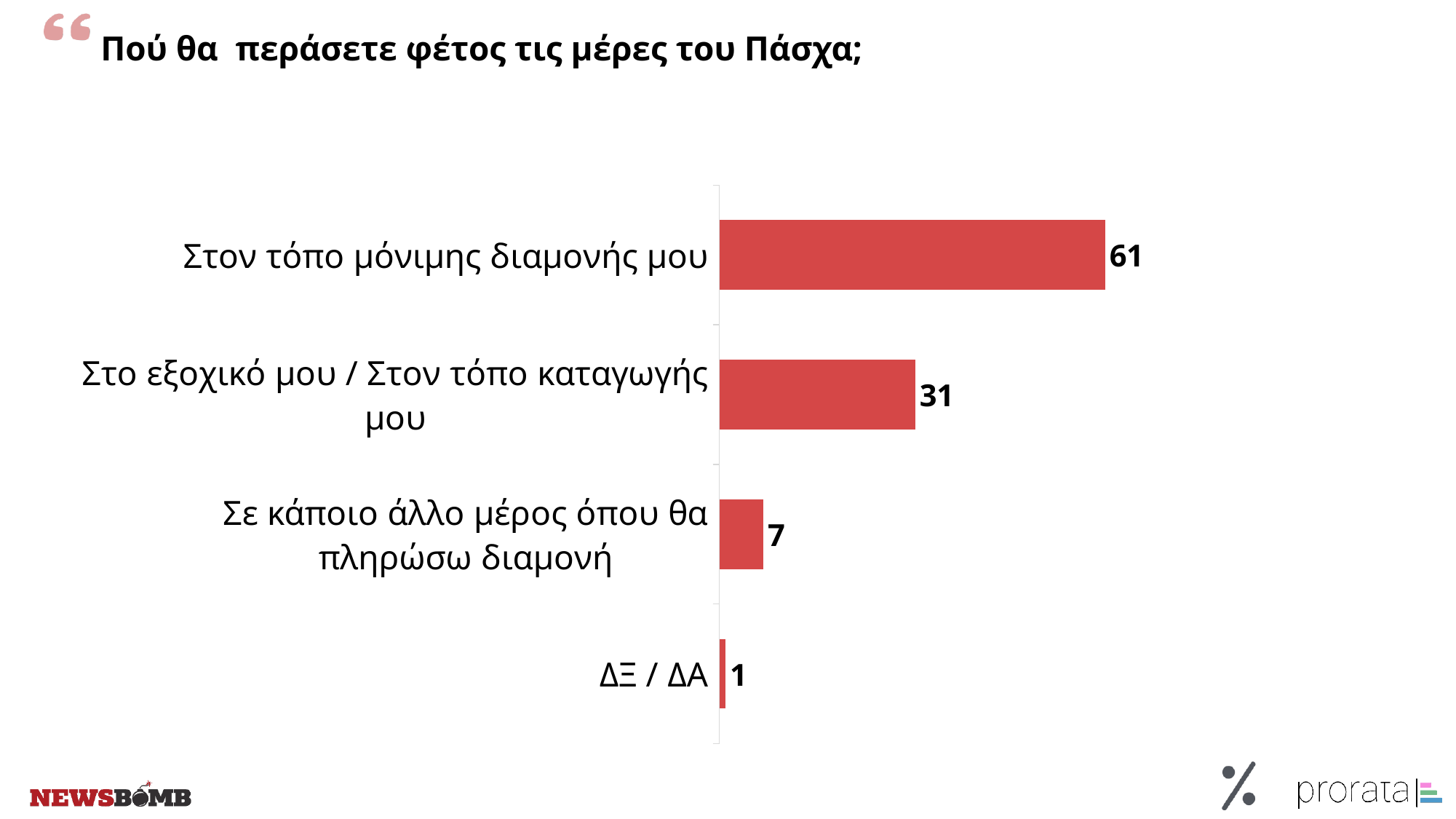
What is the value for "Στον τόπο μόνιμης διαμονής μου"? 61 What is the difference between the values for "Σε κάποιο άλλο μέρος όπου θα πληρώσω διαμονή" and "ΔΞ / ΔΑ"? 6 What is the value for "Σε κάποιο άλλο μέρος όπου θα πληρώσω διαμονή"? 7 How many categories are shown in the chart? 4 Which category has the lowest value? ΔΞ / ΔΑ What is the value for "Στο εξοχικό μου / Στον τόπο καταγωγής μου"? 31 Which is larger, the value for "Στο εξοχικό μου / Στον τόπο καταγωγής μου" or the value for "Σε κάποιο άλλο μέρος όπου θα πληρώσω διαμονή"? Στο εξοχικό μου / Στον τόπο καταγωγής μου What is the difference between the values for "Στον τόπο μόνιμης διαμονής μου" and "Στο εξοχικό μου / Στον τόπο καταγωγής μου"? 30 What kind of chart is shown on the slide? Bar chart What is the title of the chart? Πού θα περάσετε φέτος τις μέρες του Πάσχα; Which category has the highest value? Στον τόπο μόνιμης διαμονής μου What is the value for "ΔΞ / ΔΑ"? 1